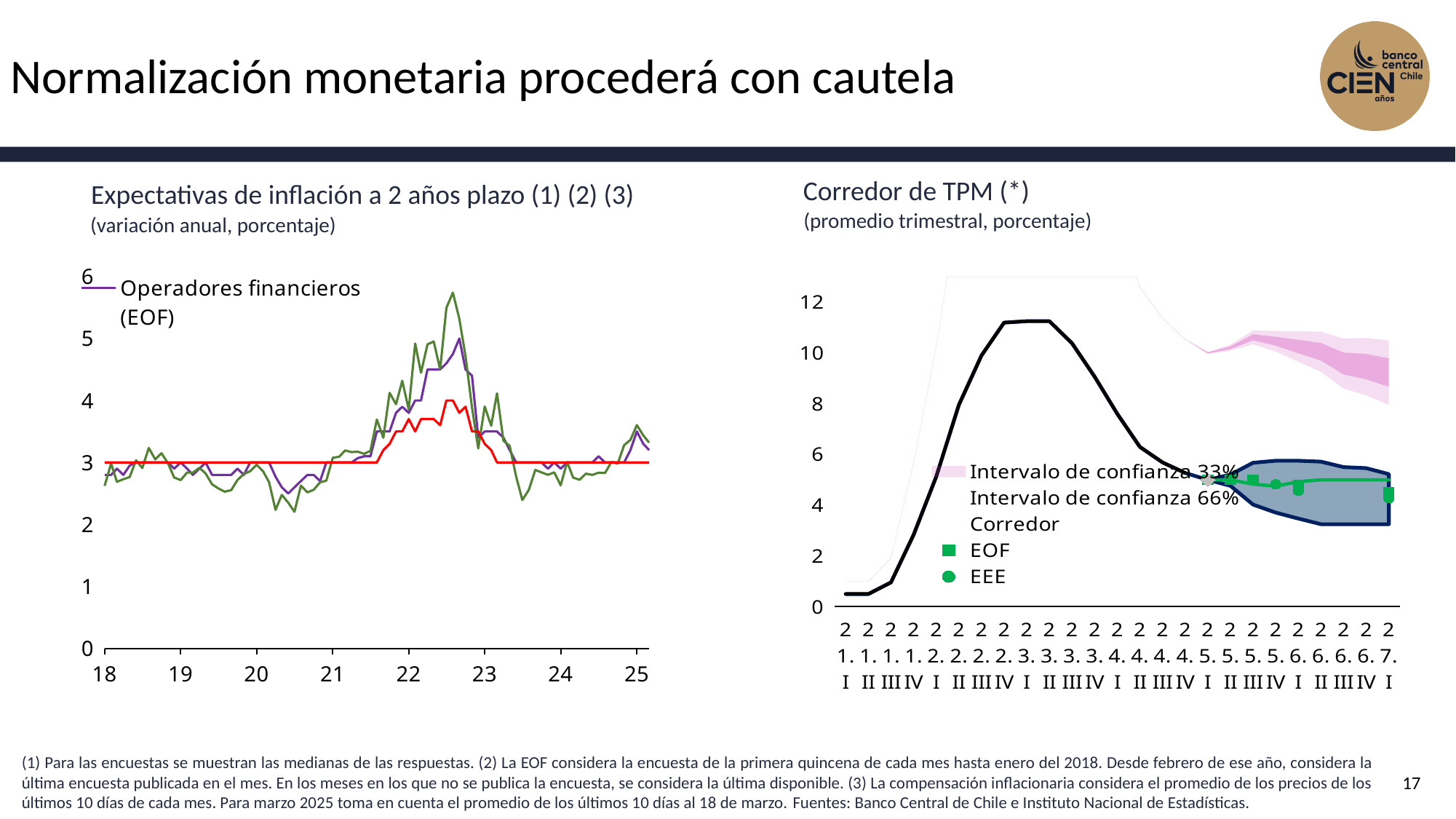
In the left chart, at the 2022 peak, which line reaches higher, the green line or the red line? green line What kind of chart is the left chart, 'Expectativas de inflación a 2 años plazo'? line chart How many entries does the legend of the right chart, 'Corredor de TPM (*)', list? 5 What kind of chart is the right chart, 'Corredor de TPM (*)'? combination area and line chart In the left chart, is the red line value in 2024 greater or less than 4? less What is the subtitle shown under the title of the right chart? (promedio trimestral, porcentaje) In the right chart, is the value of the black line at 21.I greater or less than 2? less In the right chart, is the peak of the black 'Corredor' line greater or less than 10? greater In the right chart, does the black line rise or fall between 22.IV and 24.IV? falls In the right chart, does the black line rise or fall between 21.I and 22.III? rises